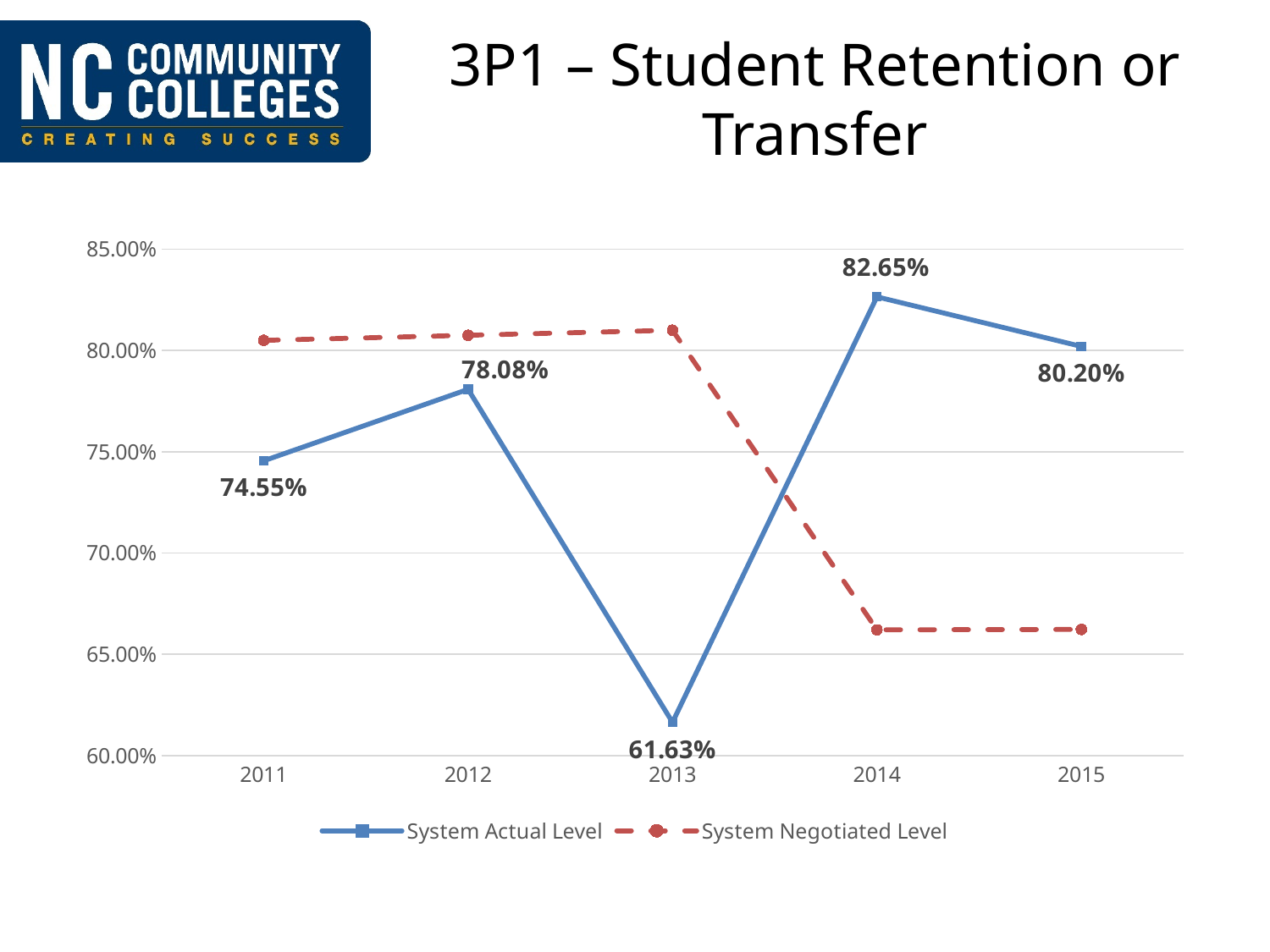
How many years are shown on the x axis? 5 What is the System Actual Level for 2011? 74.55% In which year is the System Actual Level lowest? 2013 What kind of chart is shown on the slide? line chart Is the System Negotiated Level for 2014 greater or less than 70.00%? less What is the System Actual Level for 2013? 61.63% What is the System Actual Level for 2015? 80.20% How many series does the legend list? 2 What is the difference between the System Actual Level in 2014 and in 2013? 21.02% Is the System Negotiated Level for 2012 greater or less than 80.00%? greater In which year is the System Actual Level highest? 2014 Which is larger, the System Actual Level in 2012 or in 2015? 2015